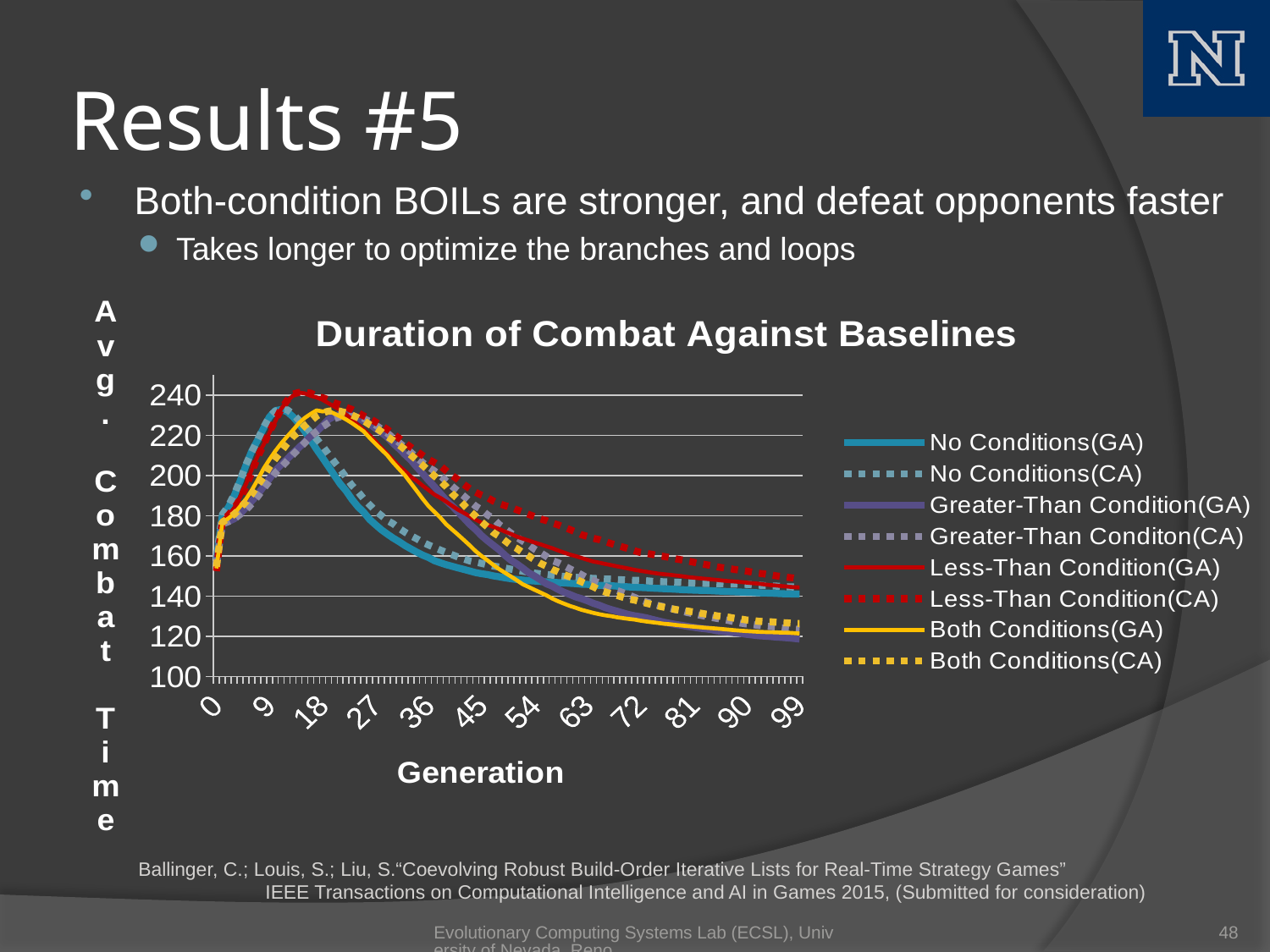
Does the Both Conditions(GA) series rise or fall from generation 18 to generation 99? fall Is the value for Both Conditions(GA) at generation 99 greater or less than 140? less How many generation tick labels are shown along the x axis? 12 At generation 36, which is larger: No Conditions(GA) or Less-Than Condition(GA)? Less-Than Condition(GA) What is the label of the x axis of the chart? Generation Is the peak value of Less-Than Condition(GA) greater or less than 220? greater Is the value for Both Conditions(GA) at generation 0 greater or less than 180? less How many series does the chart's legend list? 8 What is the title of the chart? Duration of Combat Against Baselines What kind of chart is shown on the slide? line chart